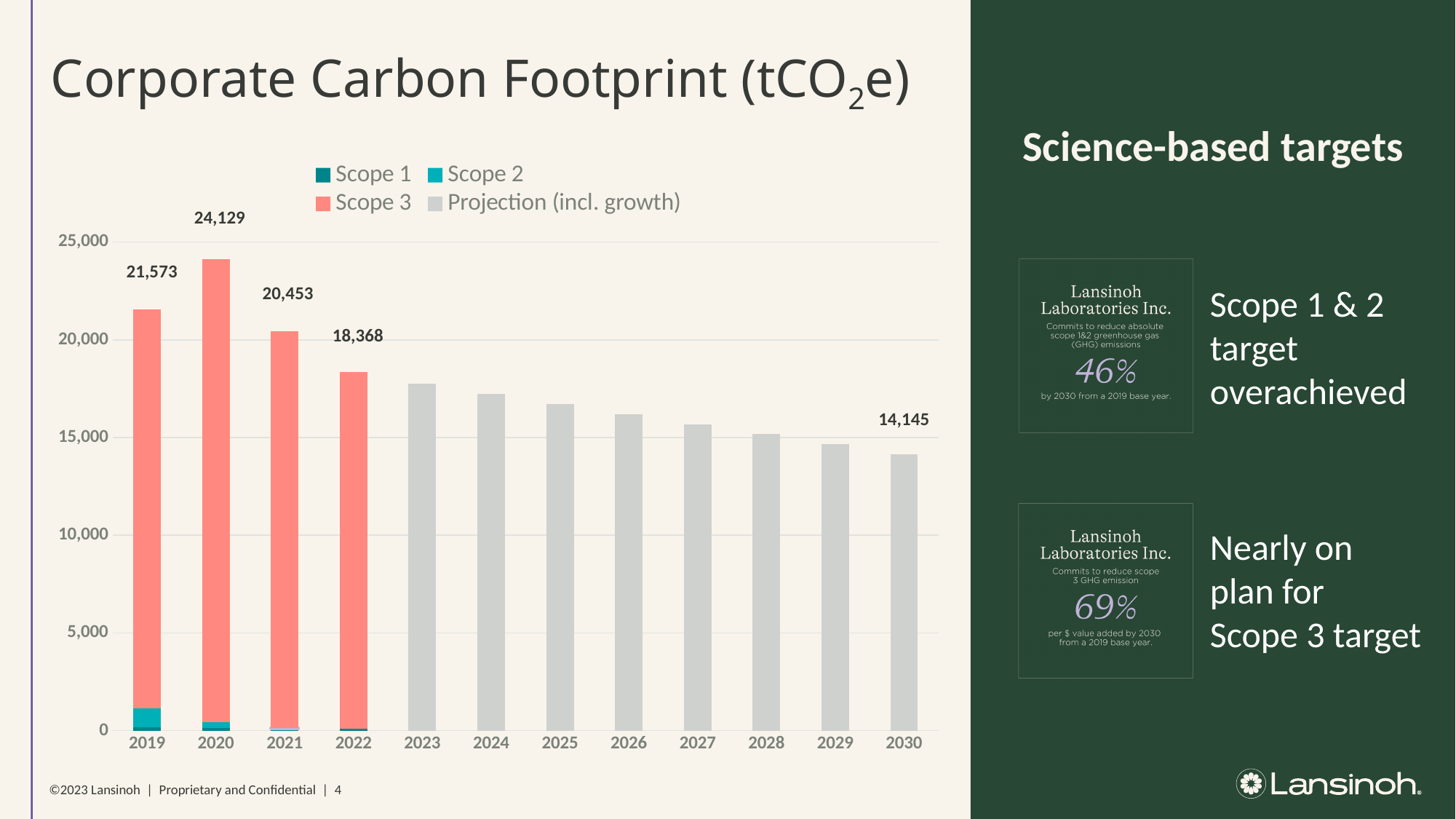
Which year has the larger total, 2019 or 2021? 2019 Is the projected value for 2026 greater or less than 15,000? greater Is the projected value for 2023 greater or less than 20,000? less Which year has the lowest bar in the chart? 2030 How many years are shown on the x axis of the chart? 12 By how much does the 2020 total exceed the 2021 total? 3,676 Which year has the highest bar in the chart? 2020 How many series does the chart legend list? 4 What value is labelled for the 2030 projection bar? 14,145 What is the total carbon footprint labelled for 2022? 18,368 What is the total carbon footprint labelled for 2020? 24,129 What is the difference between the 2019 total (21,573) and the 2022 total (18,368)? 3,205